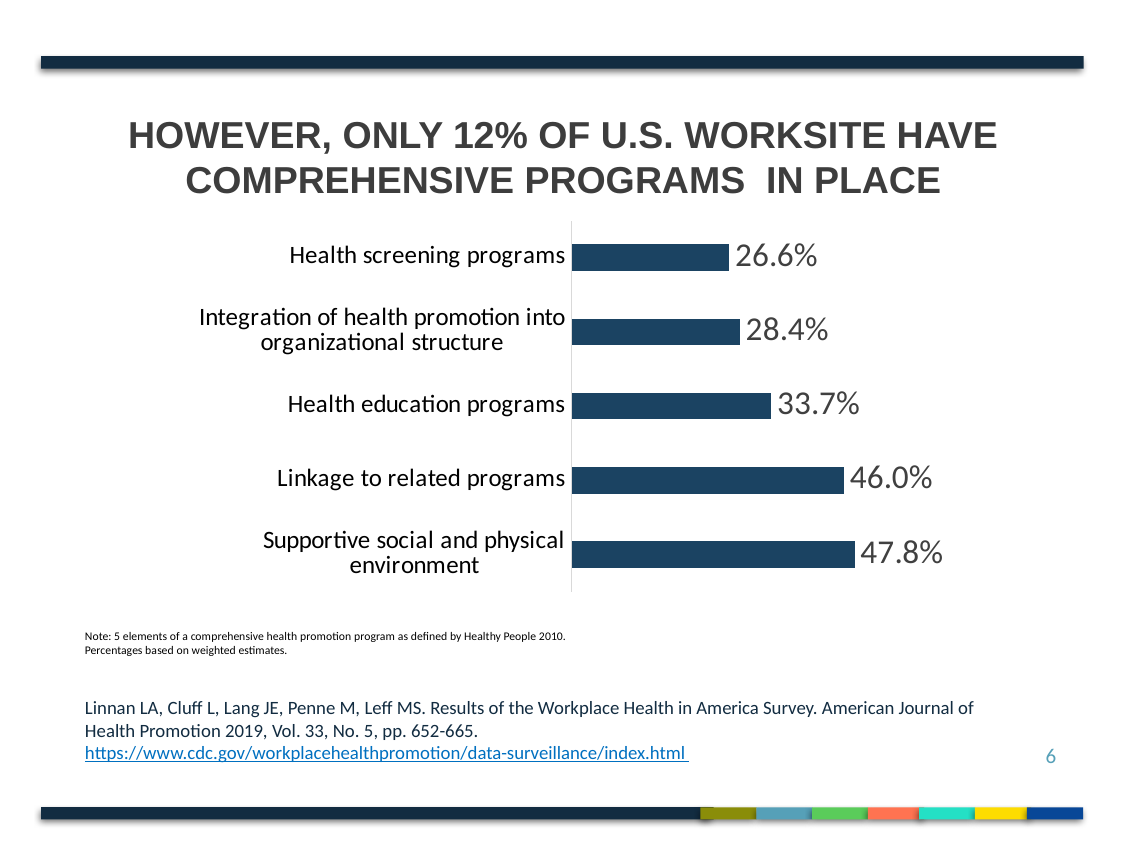
What is the value for Integration of health promotion into organizational structure? 28.4% What is the value for Health screening programs? 26.6% How many categories are shown in the chart? 5 What is the value for Health education programs? 33.7% What is the difference between the values for Linkage to related programs and Health education programs? 12.3% What kind of chart is shown on the slide? Bar chart What is the value for Supportive social and physical environment? 47.8% Which category has the lowest value? Health screening programs Which category has the highest value? Supportive social and physical environment What is the difference between the values for Supportive social and physical environment and Health screening programs? 21.2% What is the value for Linkage to related programs? 46.0% Which is larger, the value for Health education programs or the value for Integration of health promotion into organizational structure? Health education programs